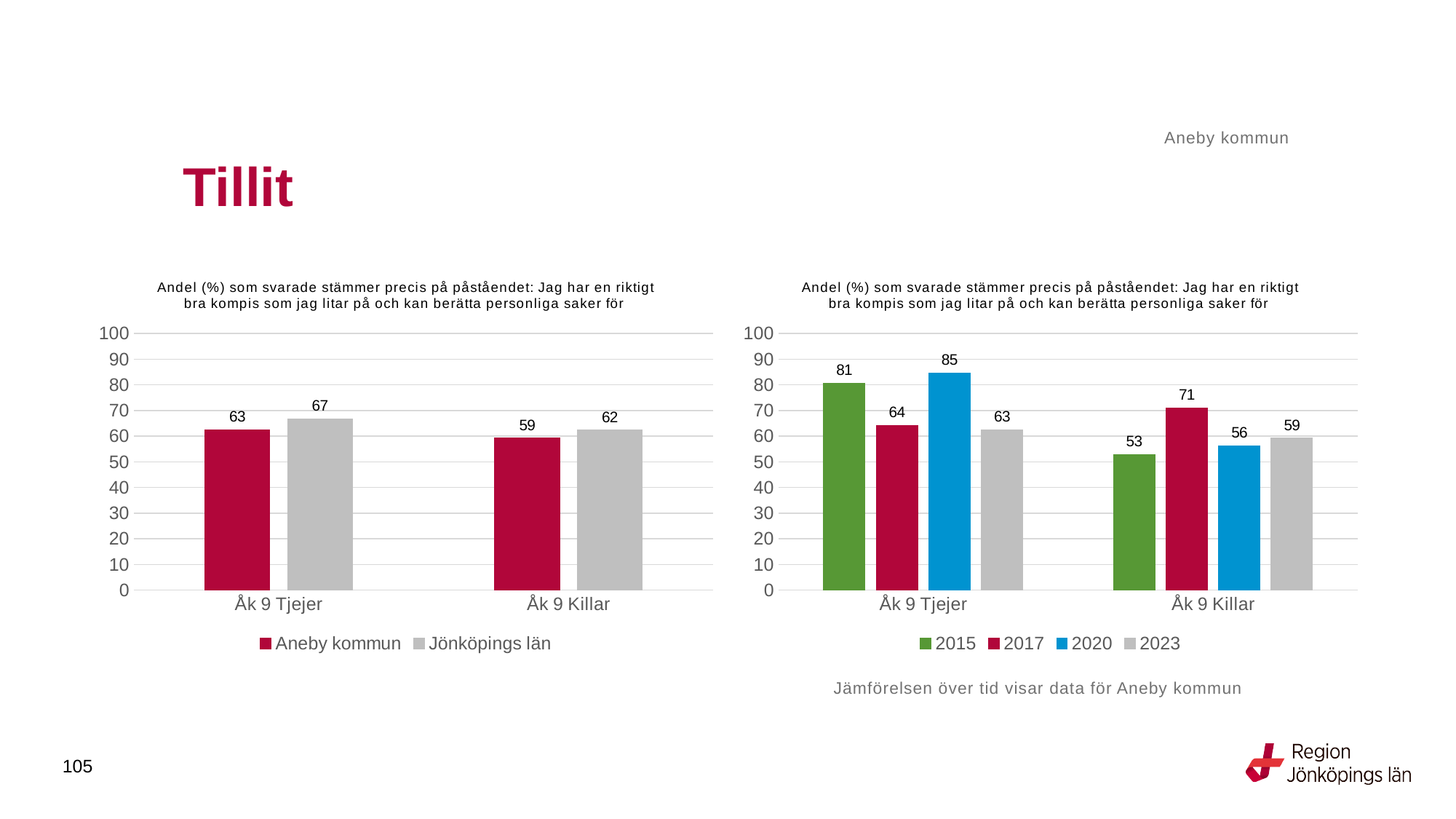
In the right chart, which year has the highest value for Åk 9 Killar? 2017 In the left chart, what is the difference between Jönköpings län and Aneby kommun for Åk 9 Tjejer? 4 In the right chart, what is the value for 2020 for Åk 9 Tjejer? 85 In the right chart, what is the value for 2015 for Åk 9 Killar? 53 In the left chart, which is larger for Åk 9 Killar: Aneby kommun or Jönköpings län? Jönköpings län In the left chart, what is the value for Jönköpings län for Åk 9 Killar? 62 In the right chart, which year has the lowest value for Åk 9 Tjejer? 2023 What kind of chart is the right chart? Bar chart In the left chart, what is the value for Aneby kommun for Åk 9 Tjejer? 63 In the right chart, what is the difference between the 2020 and 2017 values for Åk 9 Tjejer? 21 In the right chart, how many series does the legend list? 4 In the left chart, how many series does the legend list? 2